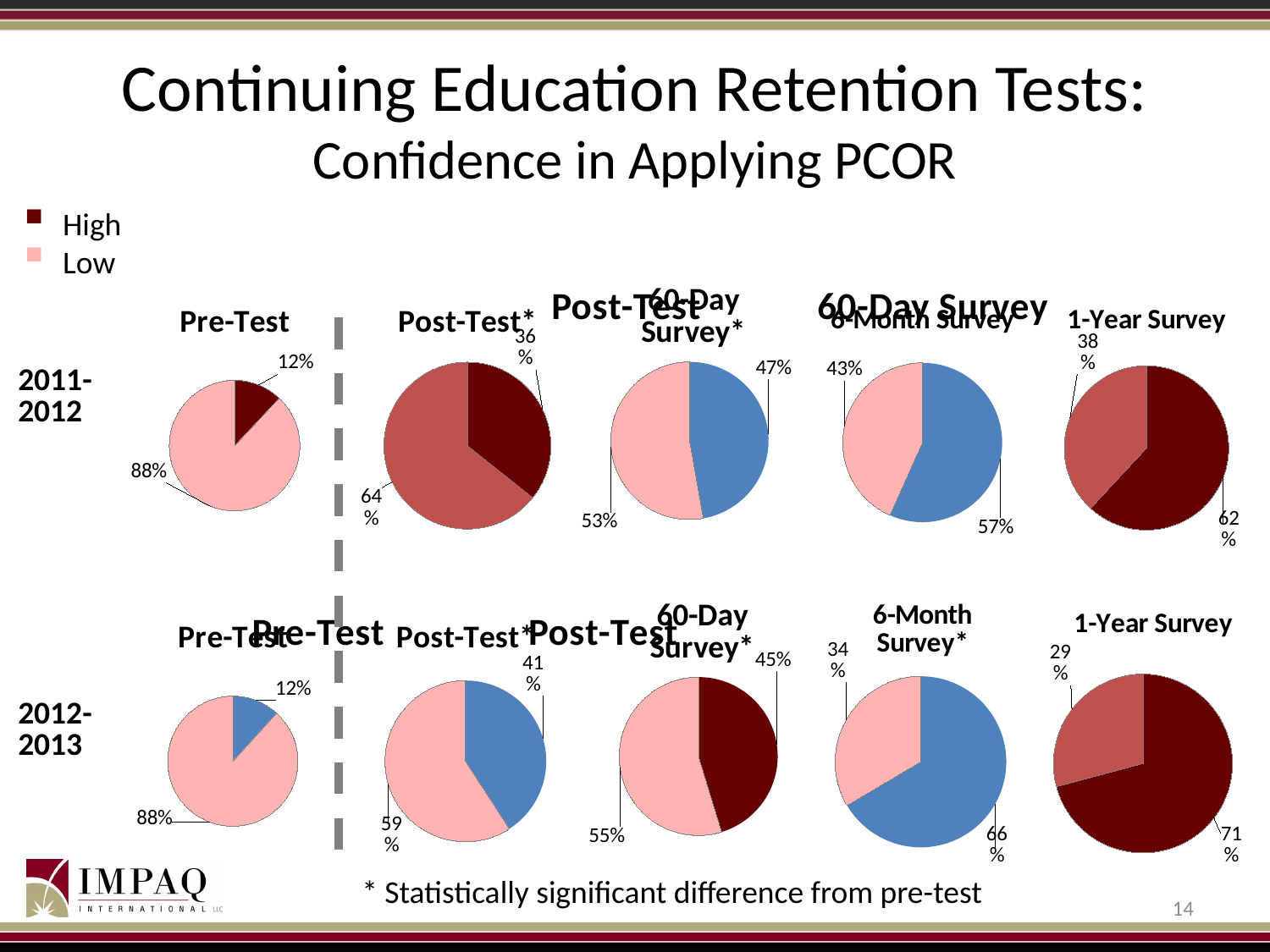
In the 2012-2013 row, which pie chart has the smallest slice? Pre-Test (12%) In the 2012-2013 6-Month Survey pie chart, what is the value of the smaller slice? 34% In the 2011-2012 Post-Test pie chart, what is the difference between the two slices (64% and 36%)? 28 percentage points How many pie charts are on the slide? 10 In the 2011-2012 6-Month Survey pie chart, what is the value of the larger slice? 57% Which Post-Test pie chart has the larger majority slice, 2011-2012 (64%) or 2012-2013 (59%)? 2011-2012 In the 2011-2012 Pre-Test pie chart, what is the value of the larger slice? 88% What are the two legend entries? High and Low In the 2012-2013 1-Year Survey pie chart, what is the value of the larger slice? 71% What kind of charts are shown on the slide? Pie charts In the 2011-2012 60-Day Survey pie chart, what is the value of the smaller slice? 47% How many entries does the legend list? 2